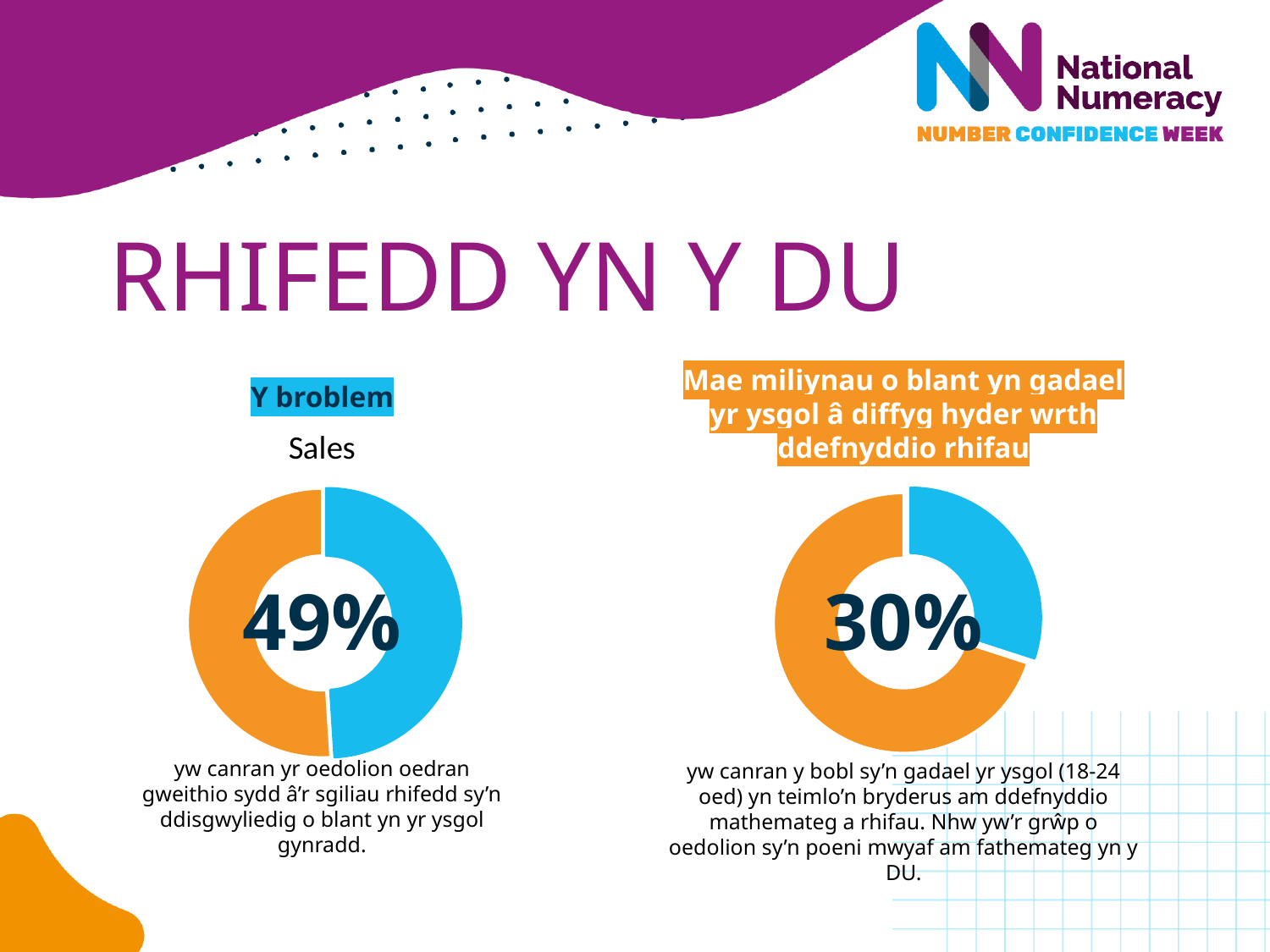
What is the difference between the percentage shown in the left chart (49%) and the percentage shown in the right chart (30%)? 19 percentage points What two colours are used for the slices in the right chart? Blue and orange How many slices does the left chart titled "Sales" have? 2 What percentage is shown in the centre of the right chart? 30% Which chart shows the larger percentage, the left chart titled "Sales" or the right chart? The left chart (Sales) What is the title of the left chart? Sales How many slices does the right chart have? 2 What percentage is shown in the centre of the left chart titled "Sales"? 49% Is the orange slice in the right chart greater or less than 50% of the whole? Greater In the right chart, which slice is larger, the blue one or the orange one? Orange What kind of chart is the left chart titled "Sales"? Pie (doughnut) chart